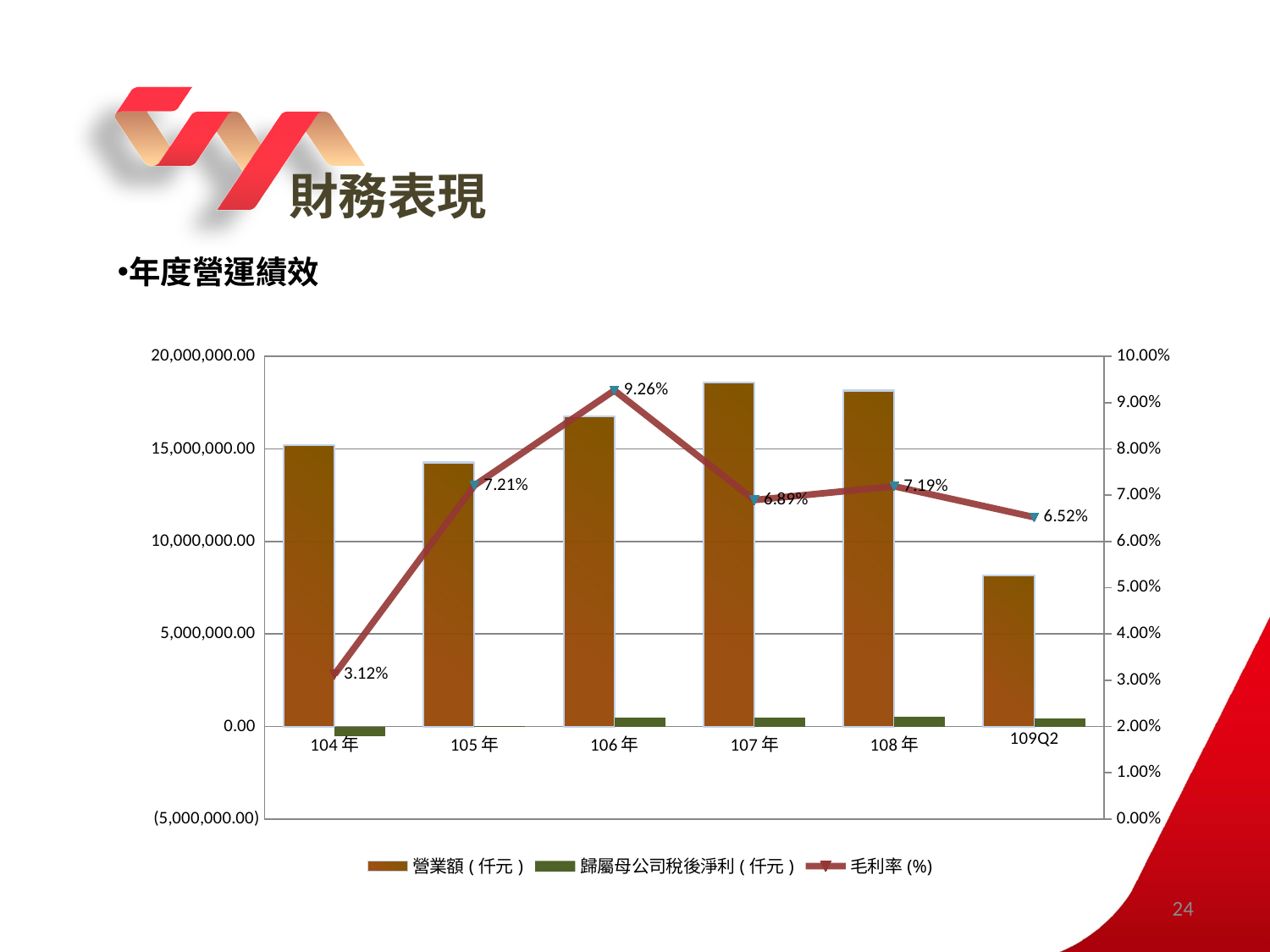
What is the 毛利率 (%) value for 104 年? 3.12% Which is larger, the 毛利率 (%) for 105 年 or for 108 年? 105 年 What is the difference between the 毛利率 (%) for 106 年 and 107 年? 2.37% Is the 營業額 ( 仟元 ) value for 109Q2 greater or less than 10,000,000.00? less Which period has the highest 營業額 ( 仟元 ) bar? 107 年 Is the 營業額 ( 仟元 ) value for 107 年 greater or less than 15,000,000.00? greater What is the 毛利率 (%) value for 106 年? 9.26% Which period has the highest 毛利率 (%)? 106 年 How many series does the chart legend list? 3 Which period has the lowest 毛利率 (%)? 104 年 How many periods are shown on the x axis of the chart? 6 What is the 毛利率 (%) value for 109Q2? 6.52%